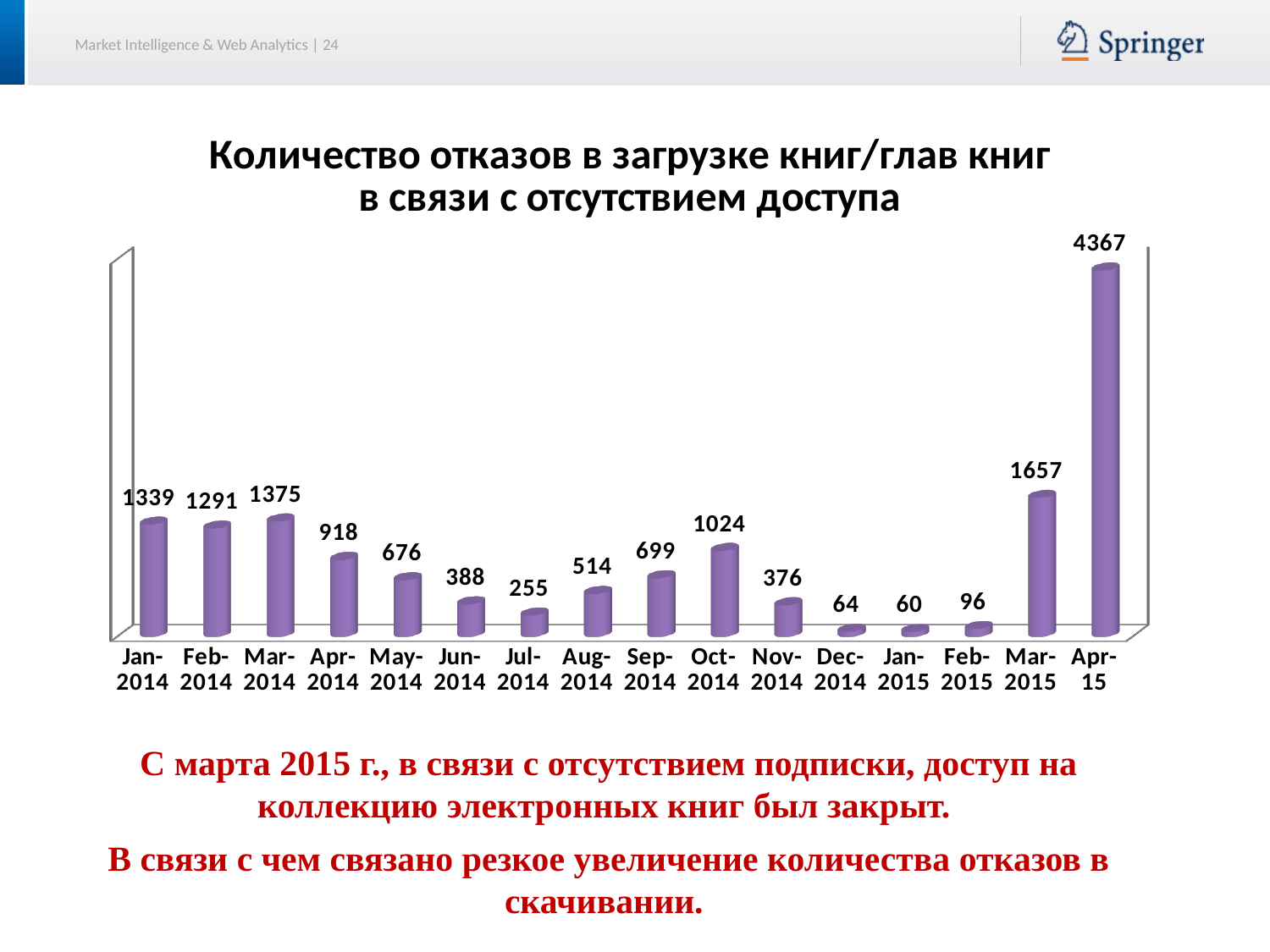
What is the value for Oct-2014? 1024 What is the difference between the values for Apr-15 and Mar-2015? 2710 Do the values rise or fall from Mar-2014 to Jul-2014? Fall How many months are shown on the x axis? 16 What kind of chart is this? Bar chart What is the value for Jan-2015? 60 What is the value for Apr-15? 4367 What is the title of the chart? Количество отказов в загрузке книг/глав книг в связи с отсутствием доступа What is the difference between the values for Mar-2014 and Feb-2014? 84 Which month has the lowest value? Jan-2015 Which is larger, the value for Sep-2014 or the value for Nov-2014? Sep-2014 Which month has the highest value? Apr-15